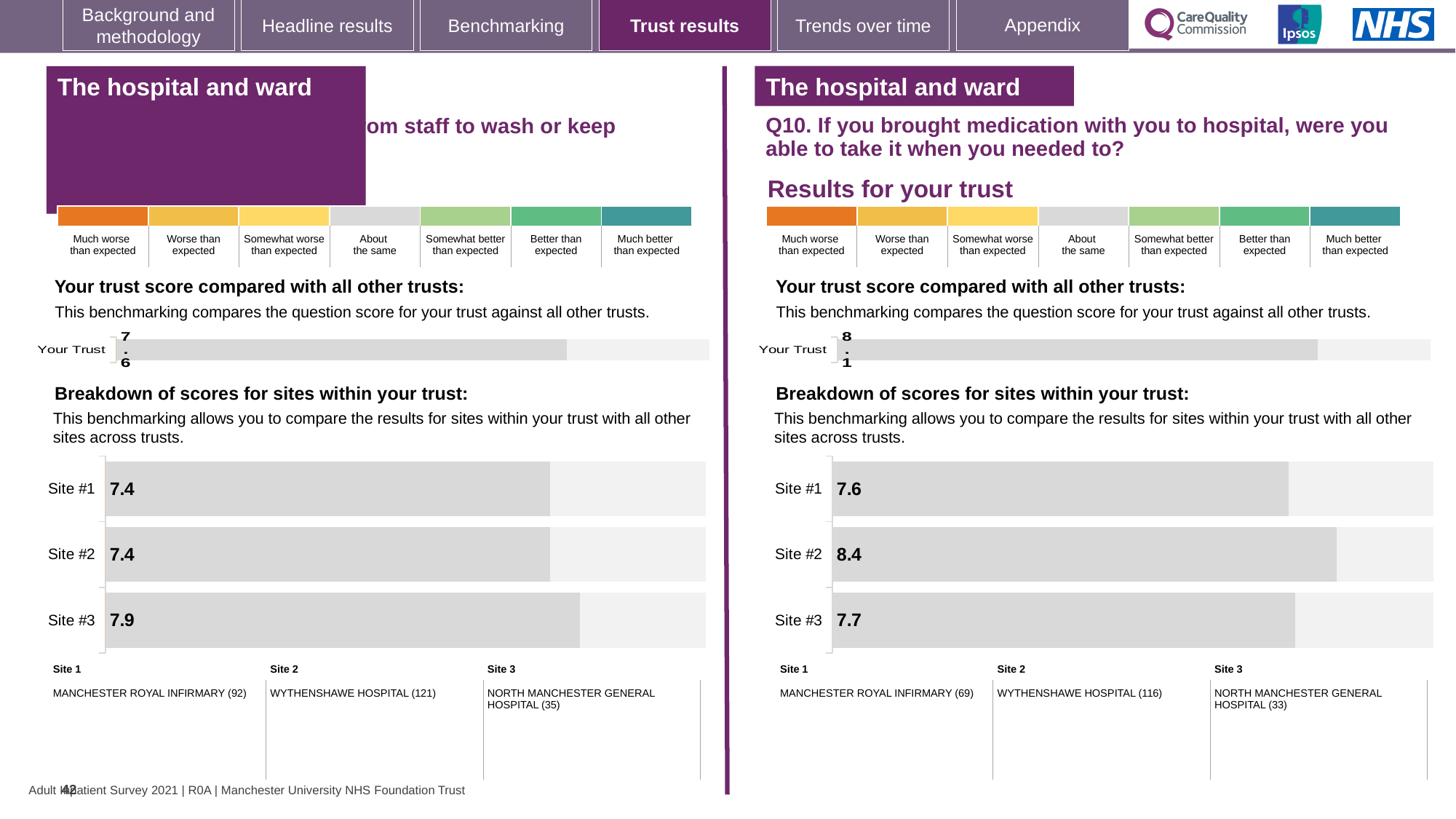
On the left-hand 'Your trust score compared with all other trusts' chart, what is the score for Your Trust? 7.6 On the right-hand Q10 site breakdown chart, what is the difference between the scores for Site #2 and Site #1? 0.8 On the right-hand Q10 'Your trust score compared with all other trusts' chart, what is the score for Your Trust? 8.1 On the right-hand Q10 site breakdown chart, what is the score for Site #2? 8.4 On the right-hand Q10 site breakdown chart, which site has the highest score? Site #2 On the left-hand site breakdown chart, which site has the highest score? Site #3 What type of chart is the right-hand Q10 site breakdown chart? Bar chart On the left-hand site breakdown chart, what is the score for Site #3? 7.9 On the right-hand Q10 site breakdown chart, which site has the lowest score? Site #1 On the right-hand Q10 site breakdown chart, which has the larger score, Site #3 or Site #1? Site #3 On the left-hand site breakdown chart, what is the difference between the scores for Site #3 and Site #1? 0.5 How many sites are shown on the left-hand site breakdown chart? 3